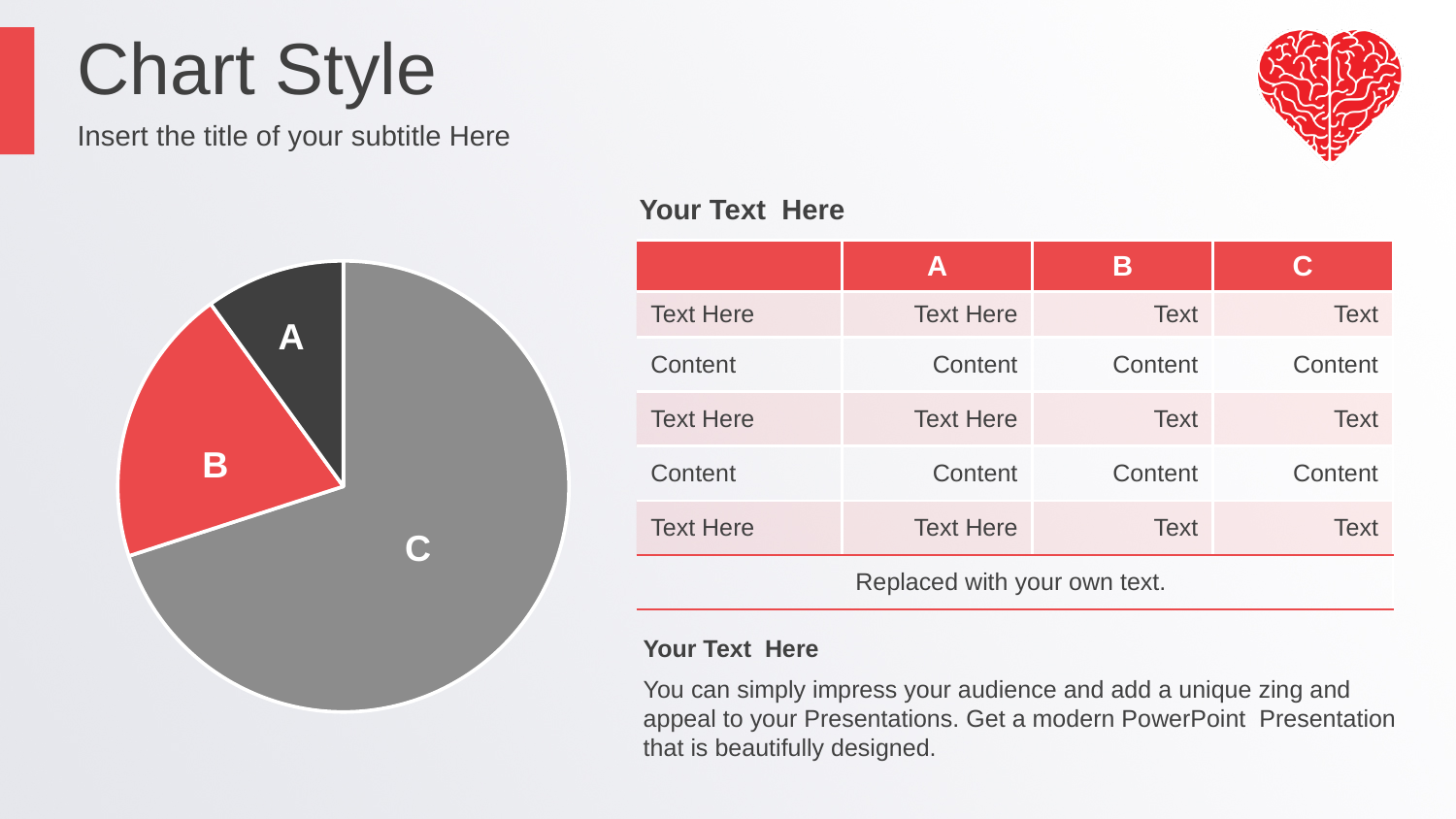
How many slices does the pie chart have? 3 Which slice is larger in the pie chart, B or C? C What kind of chart is shown on the slide? pie chart Which slice of the pie chart is the smallest? A Which slice is larger in the pie chart, A or B? B What colour is slice C in the pie chart? gray Does slice C take up more or less than half of the pie chart? more Does slice A take up more or less than a quarter of the pie chart? less What colour is slice B in the pie chart? red Which slice of the pie chart is the largest? C